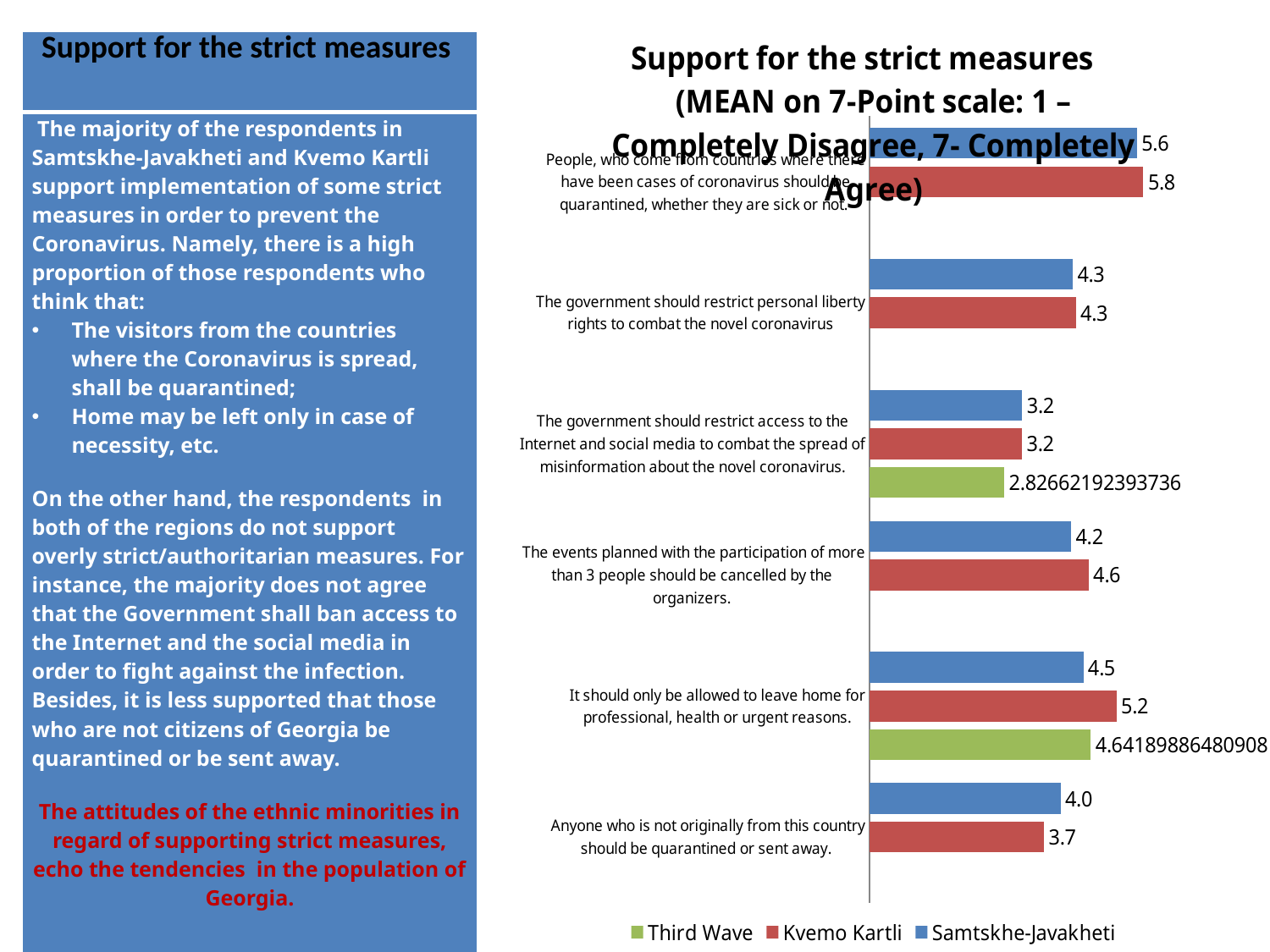
Which statement has the lowest Samtskhe-Javakheti mean? The government should restrict access to the Internet and social media to combat the spread of misinformation about the novel coronavirus. What is the Third Wave value for 'The government should restrict access to the Internet and social media to combat the spread of misinformation about the novel coronavirus'? 2.82662192393736 How many statements (categories) are plotted in the chart? 6 How many series does the chart legend list? 3 Which statement has the highest Kvemo Kartli mean? People, who come from countries where there have been cases of coronavirus should be quarantined, whether they are sick or not. What is the difference between the Kvemo Kartli and Samtskhe-Javakheti means for 'The events planned with the participation of more than 3 people should be cancelled by the organizers'? 0.4 What kind of chart is shown on the slide? bar chart What is the Samtskhe-Javakheti mean for 'The government should restrict personal liberty rights to combat the novel coronavirus'? 4.3 Which colour represents the Third Wave series in the chart? green For 'Anyone who is not originally from this country should be quarantined or sent away', which region has the higher mean, Kvemo Kartli or Samtskhe-Javakheti? Samtskhe-Javakheti What is the Kvemo Kartli mean for 'It should only be allowed to leave home for professional, health or urgent reasons'? 5.2 What is the Kvemo Kartli mean for 'People, who come from countries where there have been cases of coronavirus should be quarantined, whether they are sick or not'? 5.8